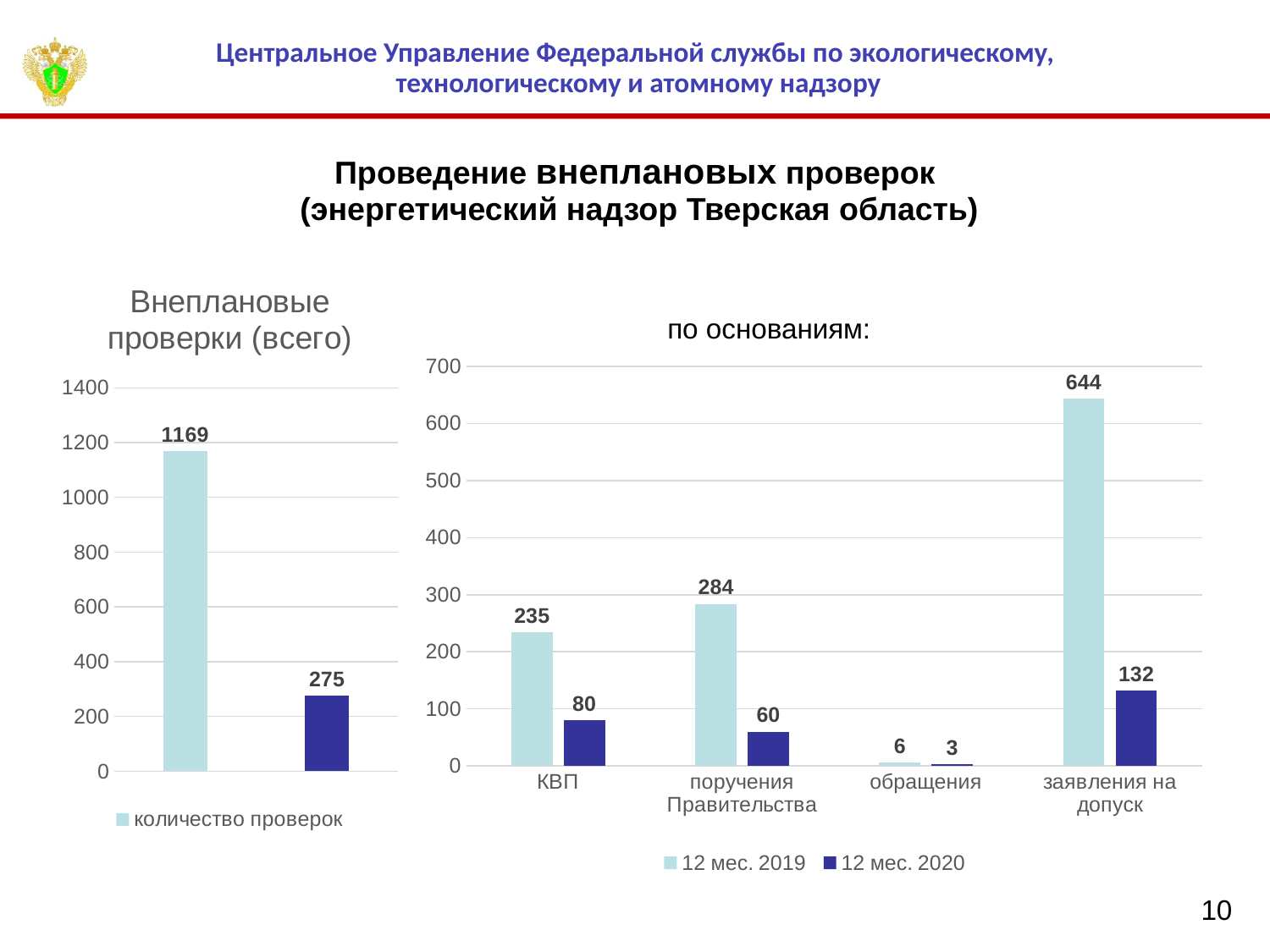
In the chart titled "по основаниям:", what is the value for КВП in the 12 мес. 2019 series? 235 In the chart titled "по основаниям:", which is larger for КВП: the 12 мес. 2019 value or the 12 мес. 2020 value? 12 мес. 2019 What kind of chart is the chart titled "Внеплановые проверки (всего)"? bar chart In the chart titled "по основаниям:", what is the value for обращения in the 12 мес. 2019 series? 6 In the chart titled "Внеплановые проверки (всего)", what is the highest value shown? 1169 In the chart titled "Внеплановые проверки (всего)", what is the difference between the two bars? 894 In the chart titled "по основаниям:", which category has the highest value in the 12 мес. 2019 series? заявления на допуск In the chart titled "по основаниям:", how many series does the legend list? 2 In the chart titled "по основаниям:", what is the difference between the 12 мес. 2019 and 12 мес. 2020 values for поручения Правительства? 224 In the chart titled "по основаниям:", how many categories are shown on the x axis? 4 In the chart titled "по основаниям:", what is the value for заявления на допуск in the 12 мес. 2020 series? 132 In the chart titled "по основаниям:", which category has the lowest value in the 12 мес. 2020 series? обращения